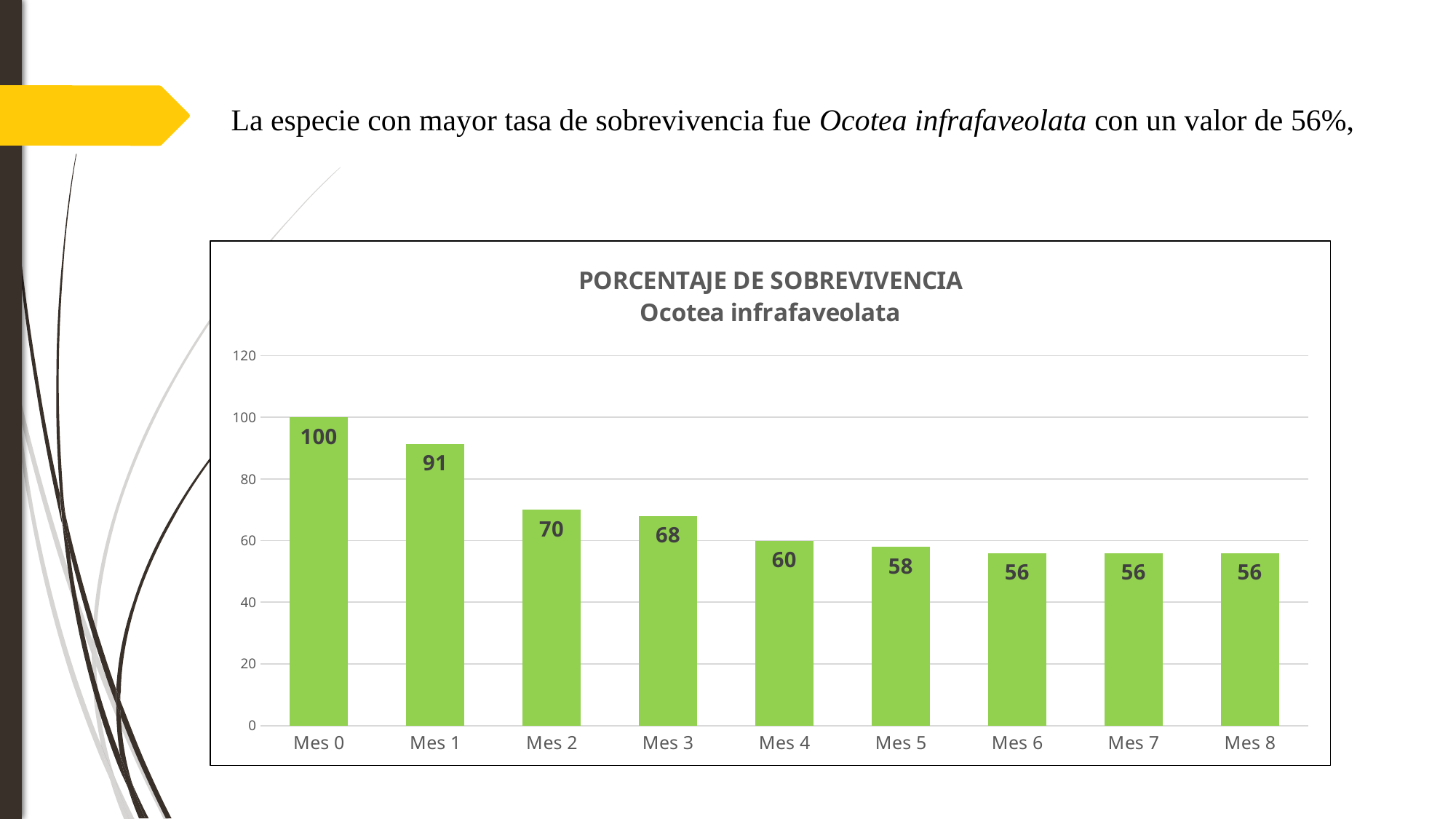
What is the difference between the values for Mes 2 and Mes 8? 14 What kind of chart is shown? bar chart What is the difference between the values for Mes 0 and Mes 1? 9 Do the values rise or fall from Mes 0 to Mes 8? fall What is the title of the chart? PORCENTAJE DE SOBREVIVENCIA Ocotea infrafaveolata What is the value for Mes 3? 68 What is the value for Mes 5? 58 Is the value for Mes 1 greater or less than 80? greater Which month has the highest value? Mes 0 What is the value for Mes 0? 100 How many months are shown on the x axis? 9 Which is larger, the value for Mes 2 or the value for Mes 4? Mes 2